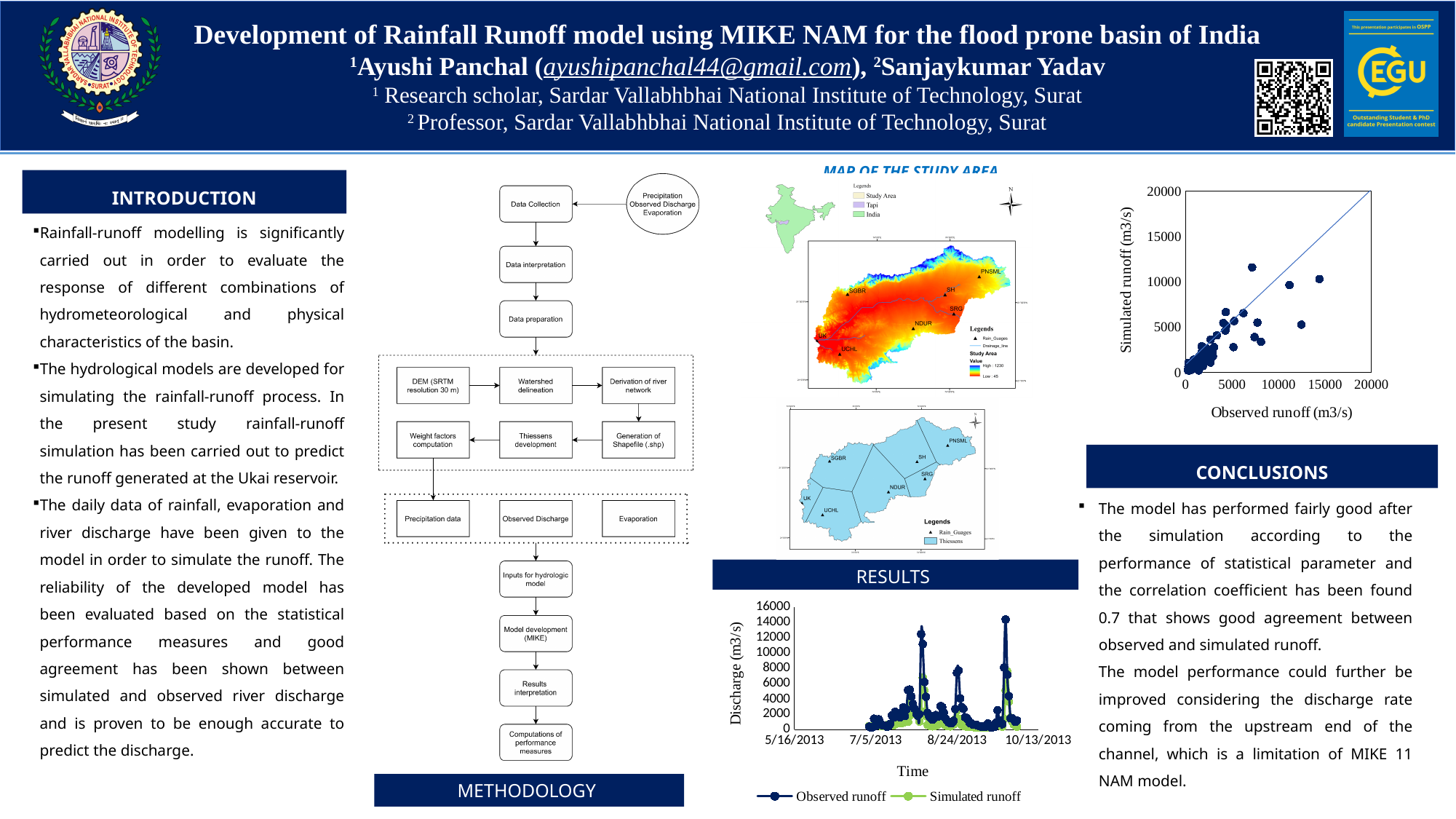
What is the maximum value shown on the y axis of the RESULTS chart? 16000 What is the y-axis label of the RESULTS chart? Discharge (m3/s) How many series does the legend of the RESULTS chart list? 2 In the RESULTS chart, is the highest peak of the Simulated runoff series greater or less than 10000? less In the scatter plot of Simulated runoff versus Observed runoff, is the largest observed runoff value greater or less than 10000? greater In the scatter plot of Simulated runoff versus Observed runoff, is the highest simulated runoff value greater or less than 15000? less In the RESULTS chart, which series reaches the higher peak discharge, Observed runoff or Simulated runoff? Observed runoff What are the two series named in the legend of the RESULTS chart? Observed runoff and Simulated runoff How many date labels are shown on the x axis of the RESULTS chart? 4 What kind of chart is the one at the top right plotting Simulated runoff against Observed runoff? scatter plot What kind of chart is the one in the RESULTS section showing Discharge against Time? line chart